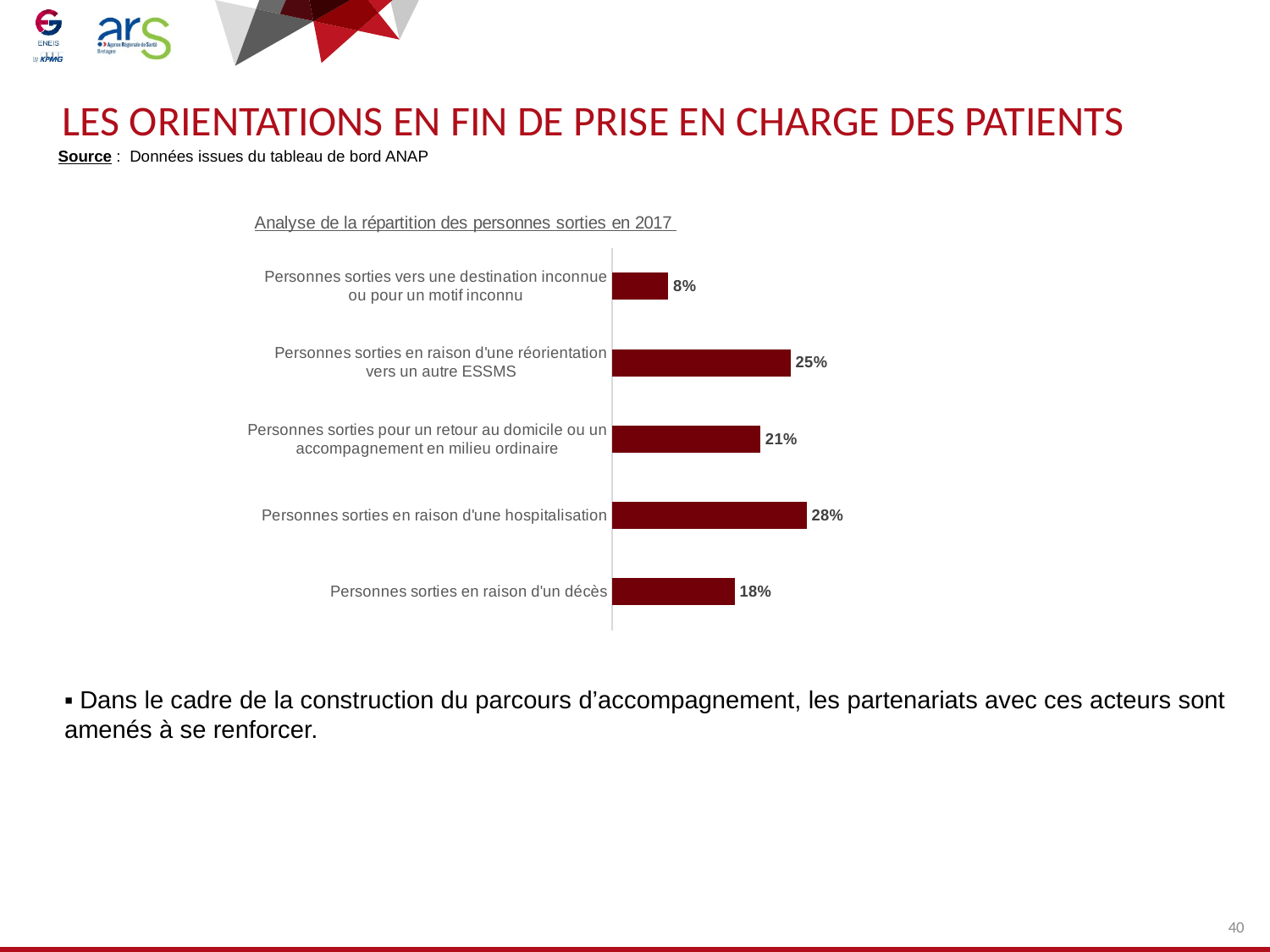
What is the value for 'Personnes sorties en raison d'une hospitalisation'? 28% What is the difference between the value for 'Personnes sorties en raison d'une hospitalisation' and the value for 'Personnes sorties en raison d'un décès'? 10% How many categories are shown in the chart? 5 What is the value for 'Personnes sorties en raison d'un décès'? 18% What is the value for 'Personnes sorties en raison d'une réorientation vers un autre ESSMS'? 25% What is the difference between the value for 'Personnes sorties pour un retour au domicile ou un accompagnement en milieu ordinaire' and the value for 'Personnes sorties vers une destination inconnue ou pour un motif inconnu'? 13% Which category has the lowest value? Personnes sorties vers une destination inconnue ou pour un motif inconnu What kind of chart is shown on the slide? Bar chart Which category has the highest value? Personnes sorties en raison d'une hospitalisation What is the title of the chart? Analyse de la répartition des personnes sorties en 2017 Which is larger: the value for 'Personnes sorties en raison d'une réorientation vers un autre ESSMS' or the value for 'Personnes sorties pour un retour au domicile ou un accompagnement en milieu ordinaire'? Personnes sorties en raison d'une réorientation vers un autre ESSMS What is the value for 'Personnes sorties vers une destination inconnue ou pour un motif inconnu'? 8%